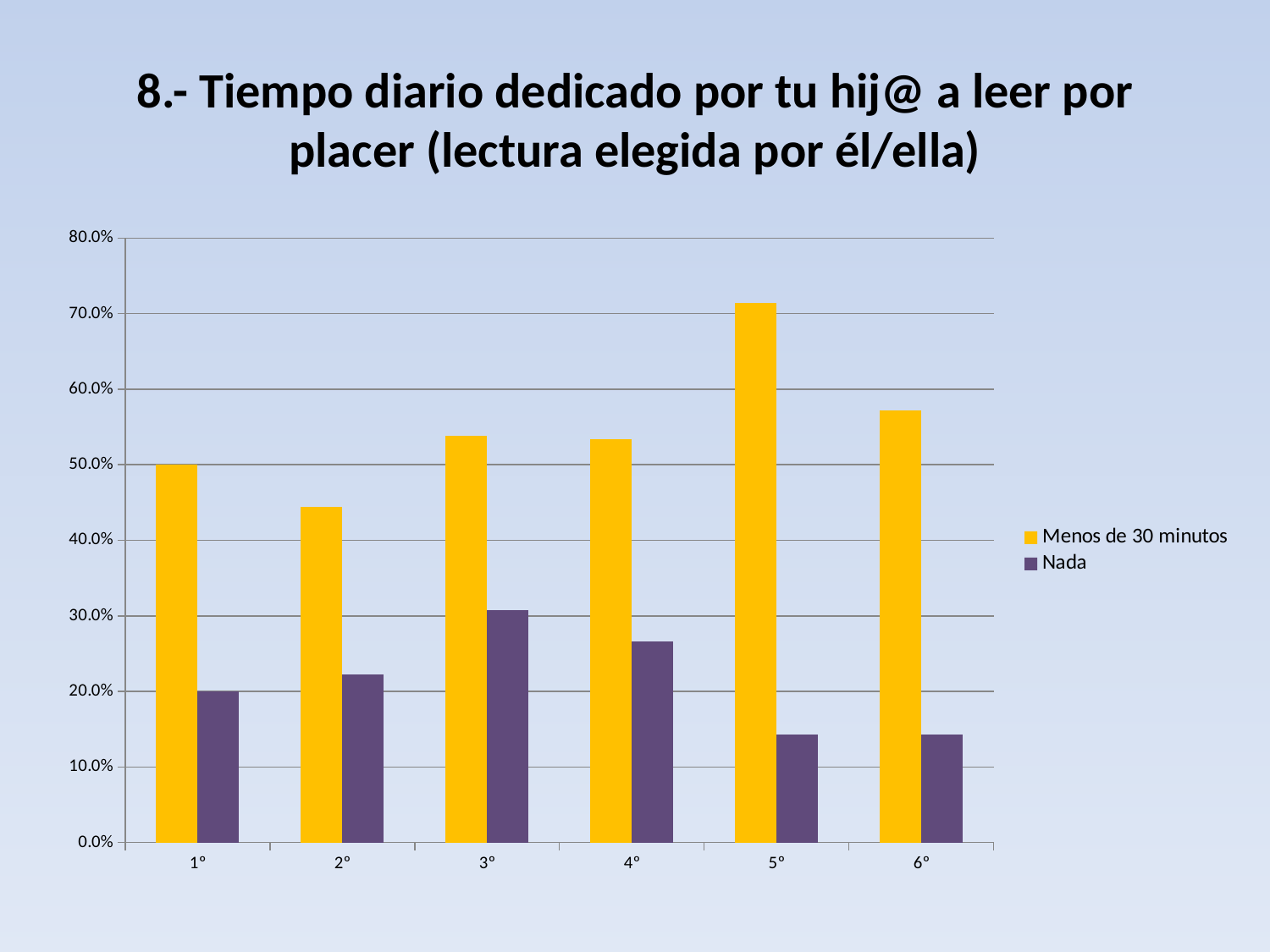
What type of chart is shown on the slide? bar chart Is the value for 'Menos de 30 minutos' in 2° greater or less than 50.0%? less Is the value for 'Menos de 30 minutos' in 5° greater or less than 70.0%? greater Which category has the highest value for 'Menos de 30 minutos'? 5° Which is larger, the 'Nada' value for 2° or for 4°? 4° Which category has the lowest value for 'Menos de 30 minutos'? 2° How many categories are shown on the x axis? 6 How many series does the legend list? 2 Is the value for 'Nada' in 5° greater or less than 20.0%? less Which category has the highest value for 'Nada'? 3° Which series is shown in yellow? Menos de 30 minutos